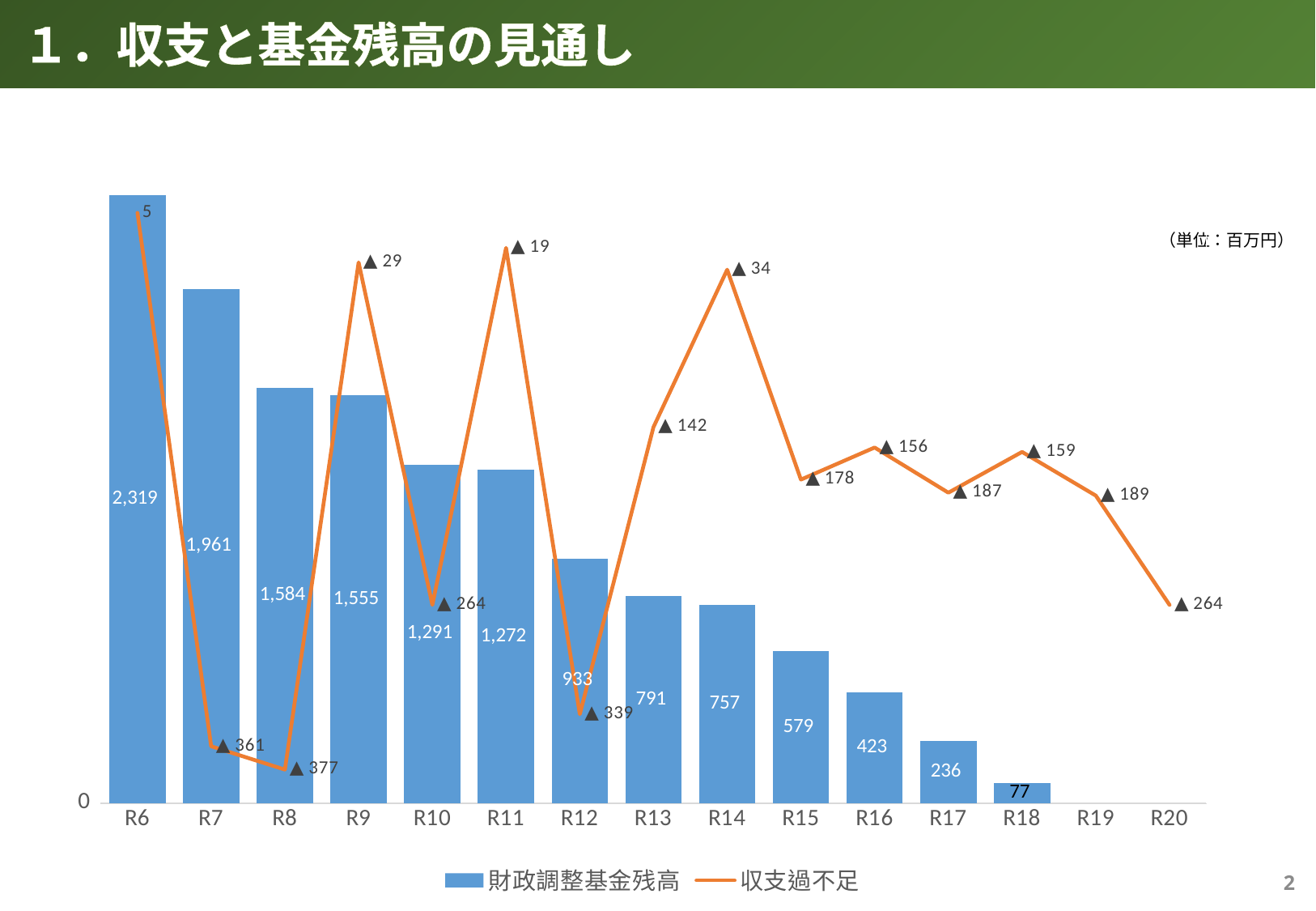
What is the value of 財政調整基金残高 for R12? 933 What is the value of 財政調整基金残高 for R6? 2,319 Among the years with a bar shown, which year has the lowest 財政調整基金残高? R18 Which is larger, the 財政調整基金残高 for R13 or for R14? R13 What is the difference between the 財政調整基金残高 values for R6 and R7? 358 What unit is stated for the values in the chart? 百万円 What is the 収支過不足 value labelled at R8? ▲377 Which year has the highest 財政調整基金残高 bar? R6 How many years are shown on the x axis? 15 Does the 財政調整基金残高 bar series rise or fall from R6 to R18? fall How many series does the legend list? 2 What is the 収支過不足 value labelled at R20? ▲264